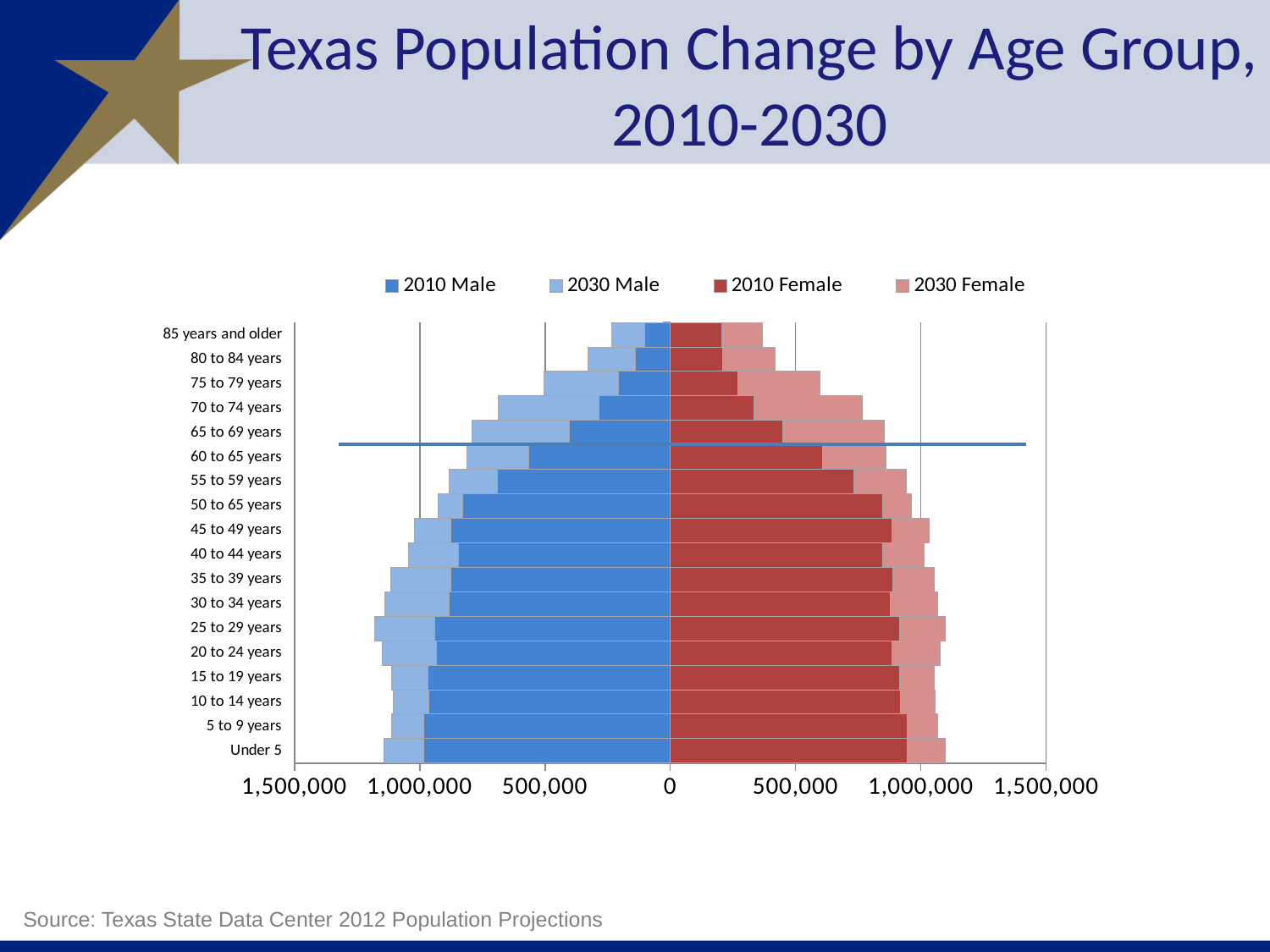
What is the title of the chart? Texas Population Change by Age Group, 2010-2030 For 70 to 74 years, which is larger: the 2010 Male value or the 2030 Male value? 2030 Male How many age groups are shown on the vertical axis? 18 Which series is shown in dark red? 2010 Female How many series does the legend list? 4 Is the 2010 Female value for 85 years and older greater or less than 500,000? less Which age group has the lowest 2010 Male value? 85 years and older Do the 2010 Male values generally rise or fall as the age groups get older? fall Is the 2010 Male value for 65 to 69 years greater or less than 500,000? less Is the 2030 Male value for Under 5 greater or less than 1,000,000? less What kind of chart is shown on the slide? bar chart